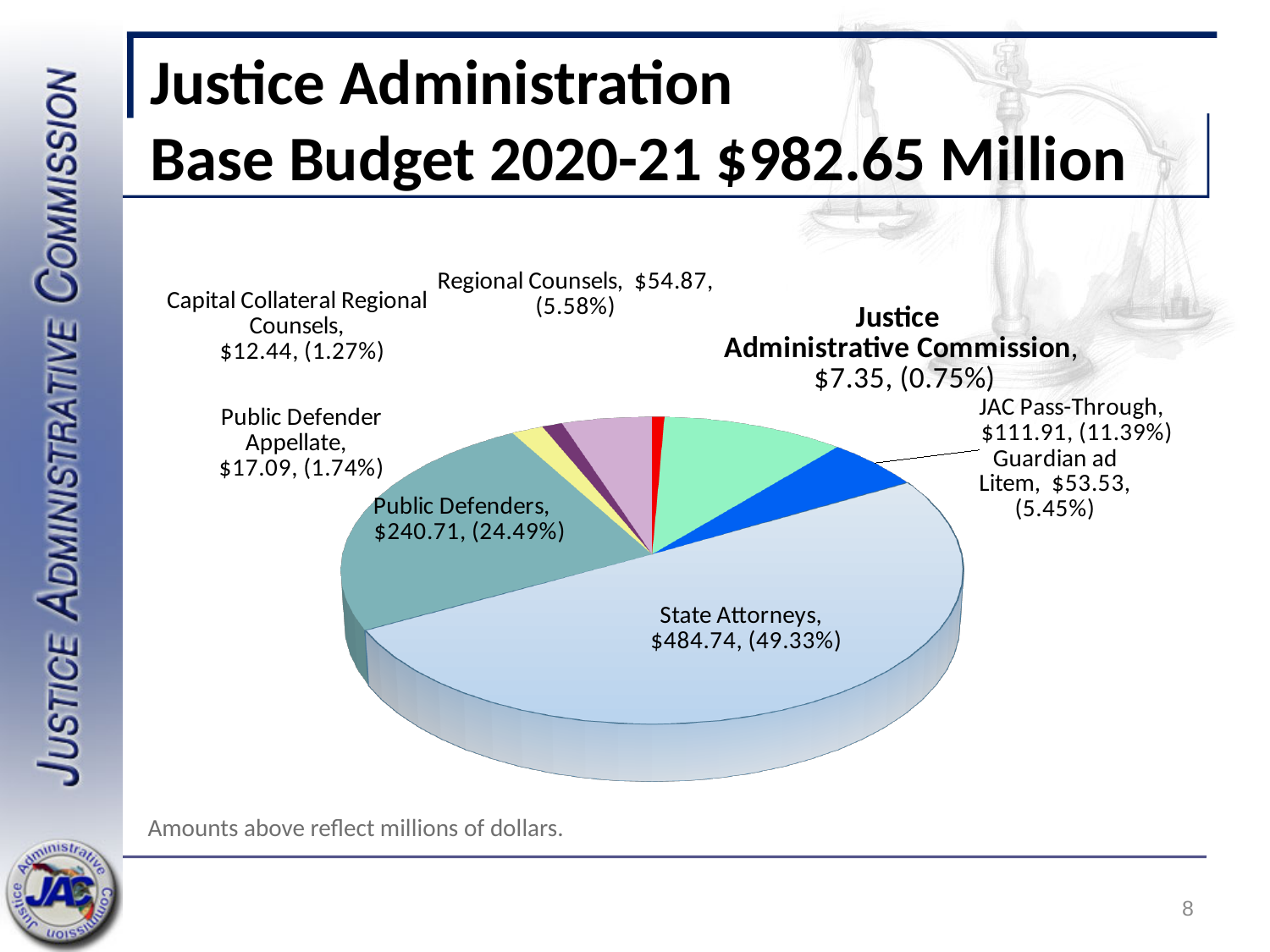
Which category has the largest slice of the pie? State Attorneys What is the value for Guardian ad Litem? $53.53 What is the value for JAC Pass-Through? $111.91 What share of the pie does Public Defenders represent? 24.49% What kind of chart is shown on the slide? Pie chart What share of the pie does Regional Counsels represent? 5.58% What is the value for Public Defenders? $240.71 Which category has the smallest slice of the pie? Justice Administrative Commission What is the value for State Attorneys? $484.74 What is the difference between the values for State Attorneys and Public Defenders? $244.03 Which is larger, the value for Public Defender Appellate or the value for Capital Collateral Regional Counsels? Public Defender Appellate How many categories are shown in the pie chart? 8